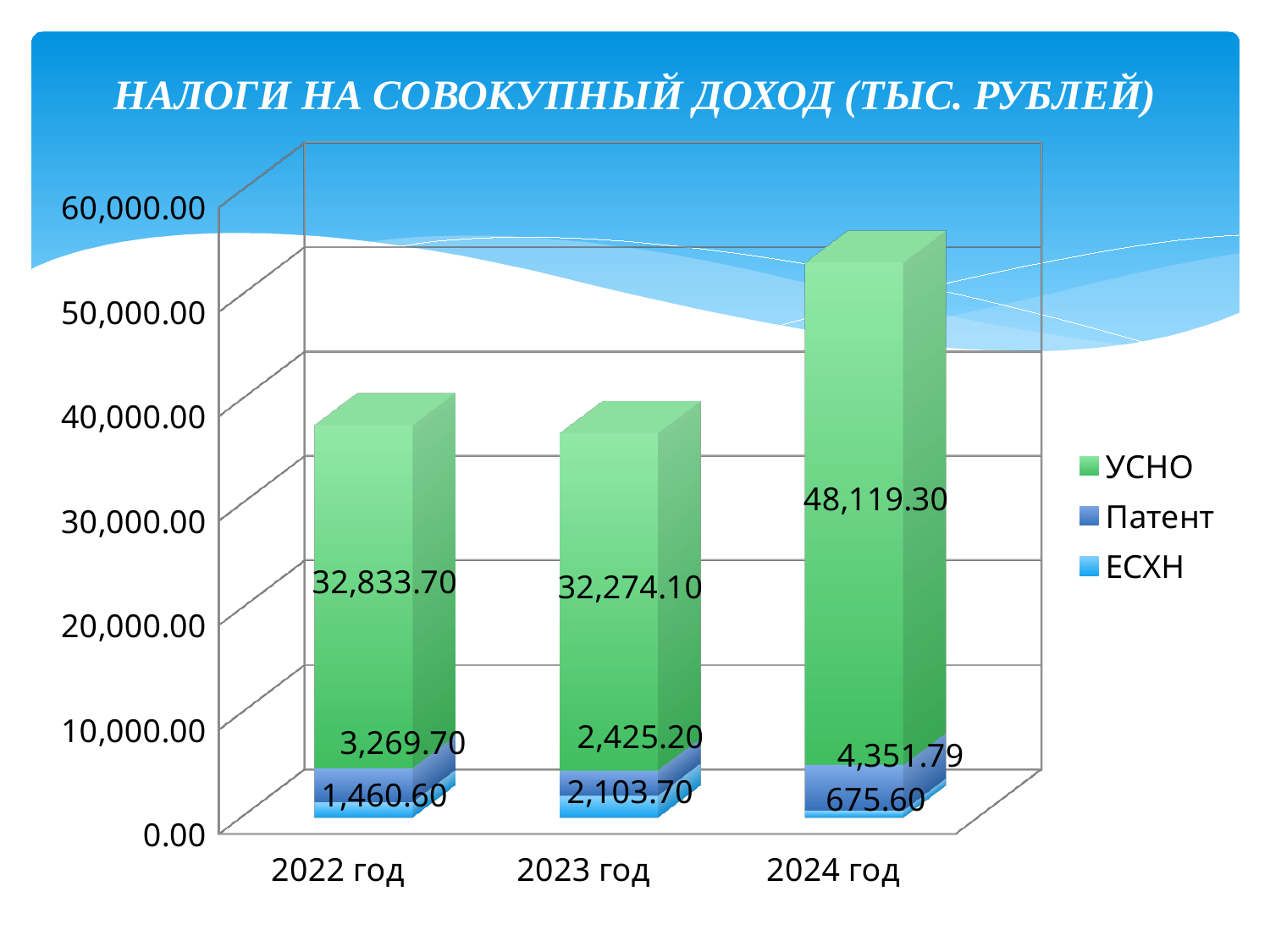
Which is larger: the УСНО value for 2022 год or for 2023 год? 2022 год What kind of chart is shown on the slide? Stacked bar chart What is the total of the stacked bar for 2022 год? 37,564.00 What is the value of ЕСХН for 2023 год? 2,103.70 What is the value of УСНО for 2024 год? 48,119.30 How many years are shown on the x axis? 3 What is the value of Патент for 2022 год? 3,269.70 In which year is the УСНО value the highest? 2024 год What is the difference between the Патент values for 2024 год and 2023 год? 1,926.59 How many series does the legend list? 3 In which year is the ЕСХН value the lowest? 2024 год What is the difference between the УСНО values for 2024 год and 2022 год? 15,285.60